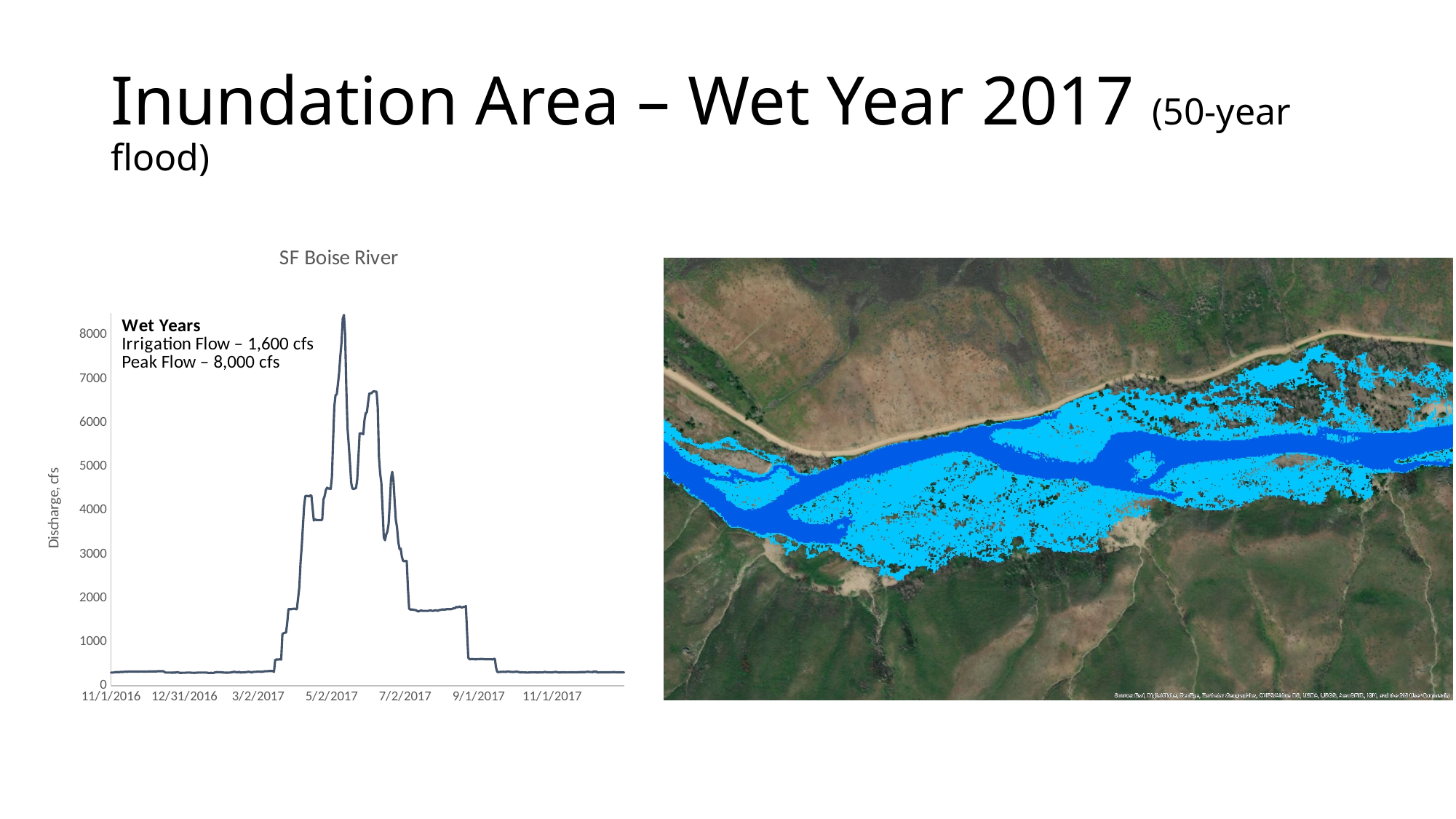
On the SF Boise River chart, is the discharge on 11/1/2016 greater or less than 1000? less According to the annotation on the SF Boise River chart, what is the Irrigation Flow for wet years? 1,600 cfs What kind of chart is the SF Boise River chart? line chart On the SF Boise River chart, is the discharge on 11/1/2017 greater or less than 1000? less What is the label of the y axis on the SF Boise River chart? Discharge, cfs On the SF Boise River chart, does the discharge rise or fall between 7/2/2017 and 11/1/2017? fall On the SF Boise River chart, is the highest discharge value greater or less than 7000? greater On the SF Boise River chart, which date has the larger discharge, 5/2/2017 or 12/31/2016? 5/2/2017 How many date labels are shown on the x axis of the SF Boise River chart? 7 What is the title of the chart on the left of the slide? SF Boise River On the SF Boise River chart, does the discharge rise or fall between 3/2/2017 and 5/2/2017? rise According to the annotation on the SF Boise River chart, what is the Peak Flow for wet years? 8,000 cfs